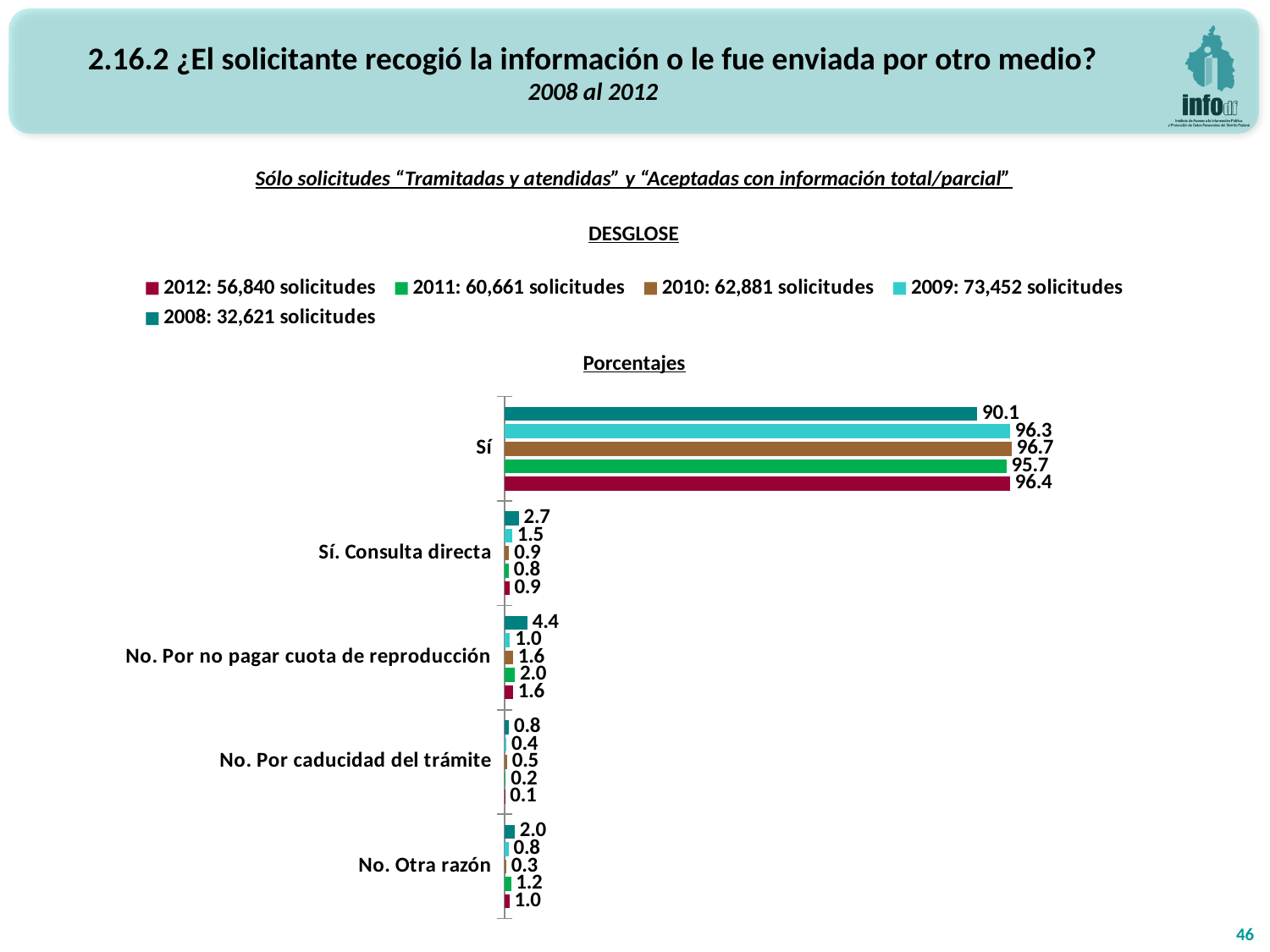
What is the value for 'No. Otra razón' in the 2011 series? 1.2 What kind of chart is shown on the slide? bar chart What is the difference between the 2010 and 2008 values for 'Sí'? 6.6 Which is larger for 'No. Por caducidad del trámite': the 2008 value or the 2012 value? 2008 According to the legend, how many solicitudes were there in 2009? 73,452 What is the value for 'No. Por no pagar cuota de reproducción' in the 2008 series? 4.4 How many series does the legend list? 5 What is the value for 'Sí' in the 2010 series? 96.7 What is the value for 'Sí' in the 2008 series? 90.1 How many categories are shown on the chart? 5 Which year has the lowest value for 'Sí'? 2008 Which year has the highest value for 'Sí. Consulta directa'? 2008